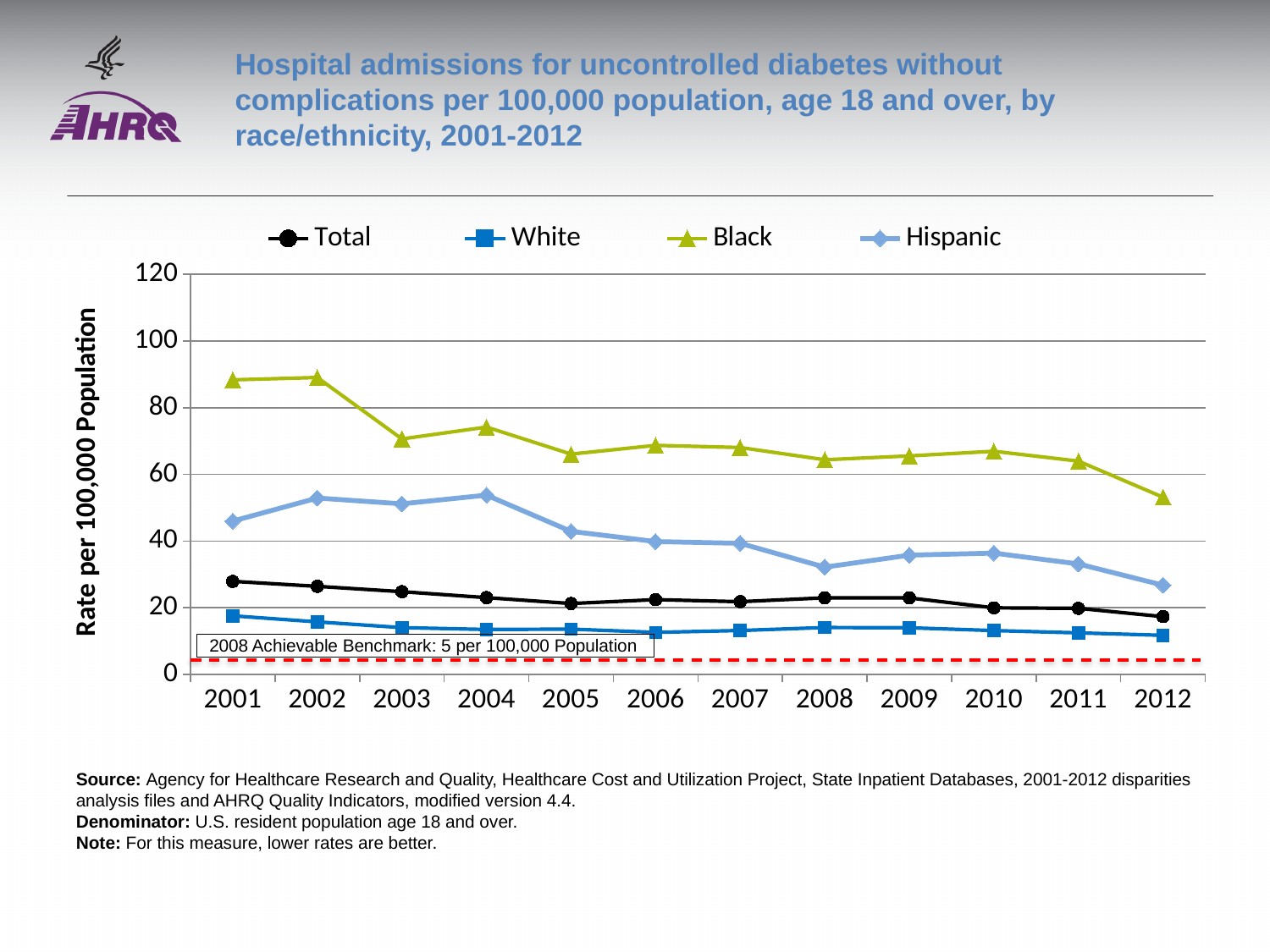
What is the 2008 Achievable Benchmark shown on the chart? 5 per 100,000 Population Which series has the lowest rate in 2012? White Which race/ethnicity group has the highest hospital admission rate in 2001? Black What kind of chart is shown on the slide? line chart How many series does the legend list? 4 Is the value for Black in 2001 greater or less than 80? greater How many years are plotted along the x axis? 12 Is the value for White in 2012 greater or less than 20? less Which is larger in 2004, the value for Black or the value for Hispanic? Black Is the value for Hispanic in 2001 greater or less than 40? greater Does the Black series generally rise or fall from 2001 to 2012? fall